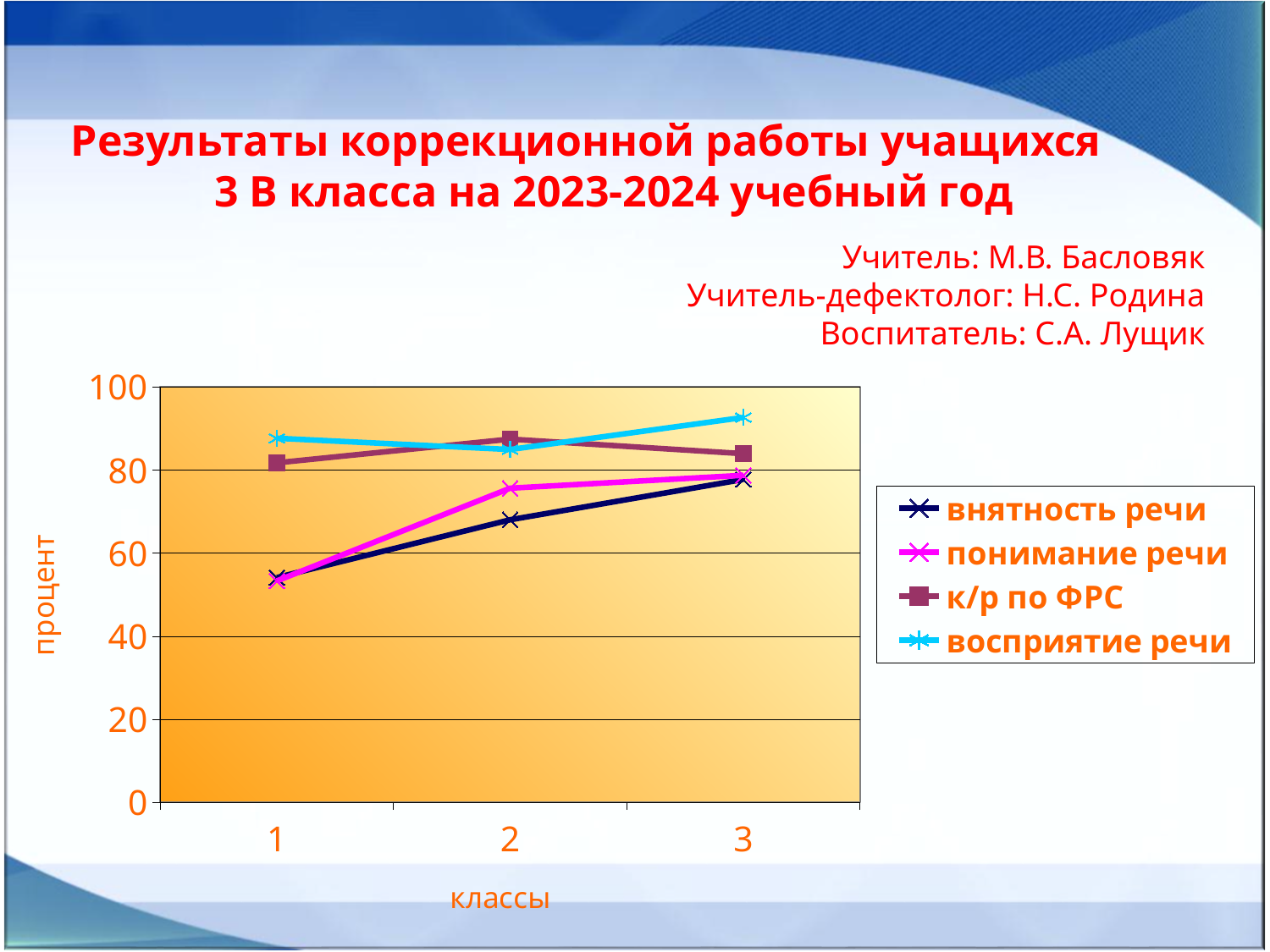
At class 1, which is larger: восприятие речи or внятность речи? восприятие речи Is the value for к/р по ФРС at class 2 greater or less than 80? greater How many classes (categories) are plotted along the x axis? 3 Is the value for понимание речи at class 2 greater or less than 80? less Is the value for восприятие речи at class 3 greater or less than 80? greater Which series has the lowest value at class 2? внятность речи Which series has the highest value at class 3? восприятие речи Does the value for внятность речи rise or fall from class 1 to class 3? rise How many series does the legend list? 4 What is the label of the vertical axis? процент What kind of chart is shown on the slide? line chart